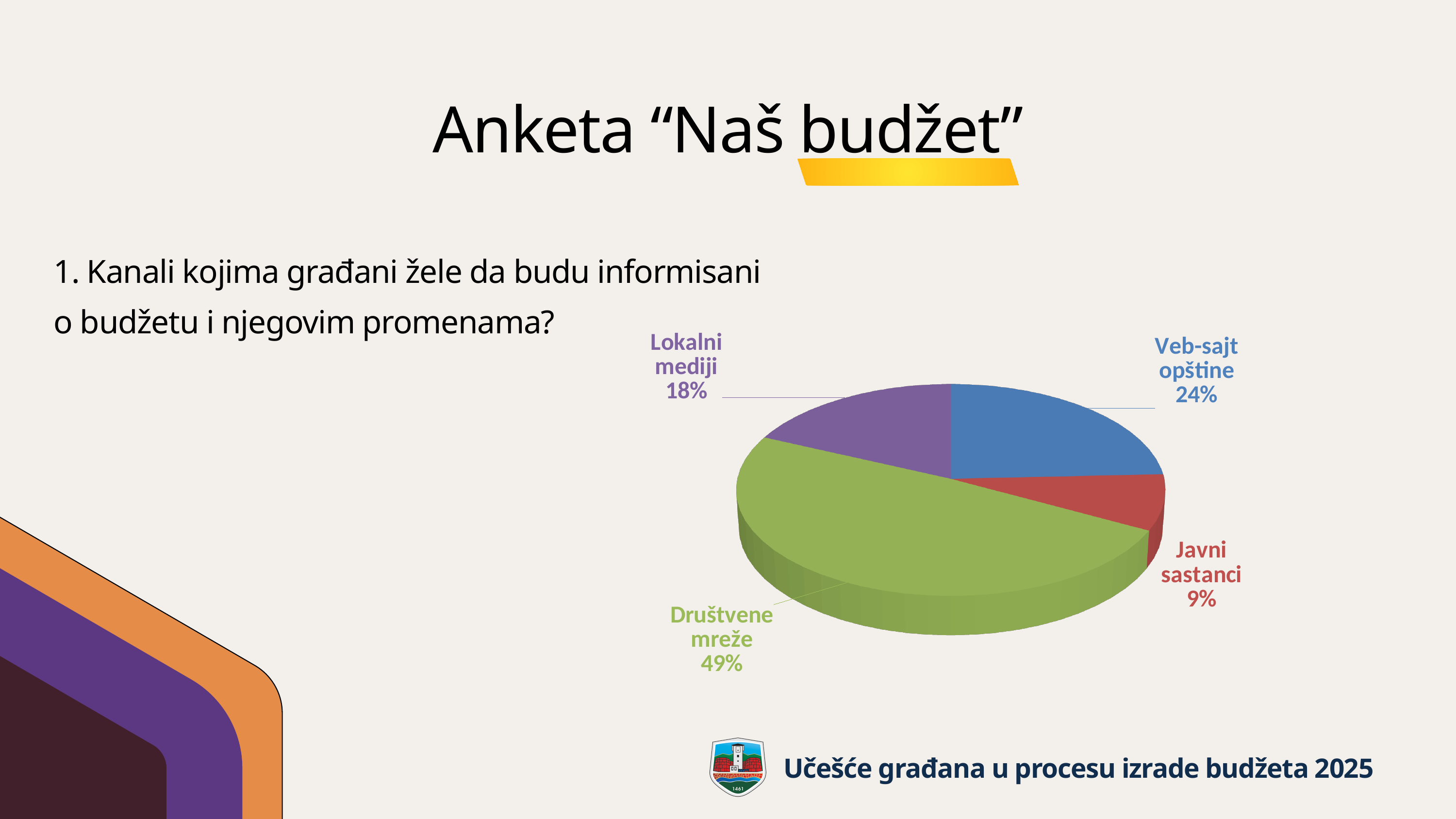
Which category has the smallest slice of the pie? Javni sastanci Which is larger, the value for Veb-sajt opštine or the value for Javni sastanci? Veb-sajt opštine How many categories are shown in the pie chart? 4 What colour is the slice for Društvene mreže? green What is the value for Lokalni mediji? 18% What is the value for Javni sastanci? 9% What is the difference between the values for Društvene mreže and Javni sastanci? 40% What share of the pie does Društvene mreže have? 49% Which category has the largest slice of the pie? Društvene mreže What kind of chart is shown on the slide? pie chart What is the value for Veb-sajt opštine? 24% What is the difference between the values for Veb-sajt opštine and Lokalni mediji? 6%